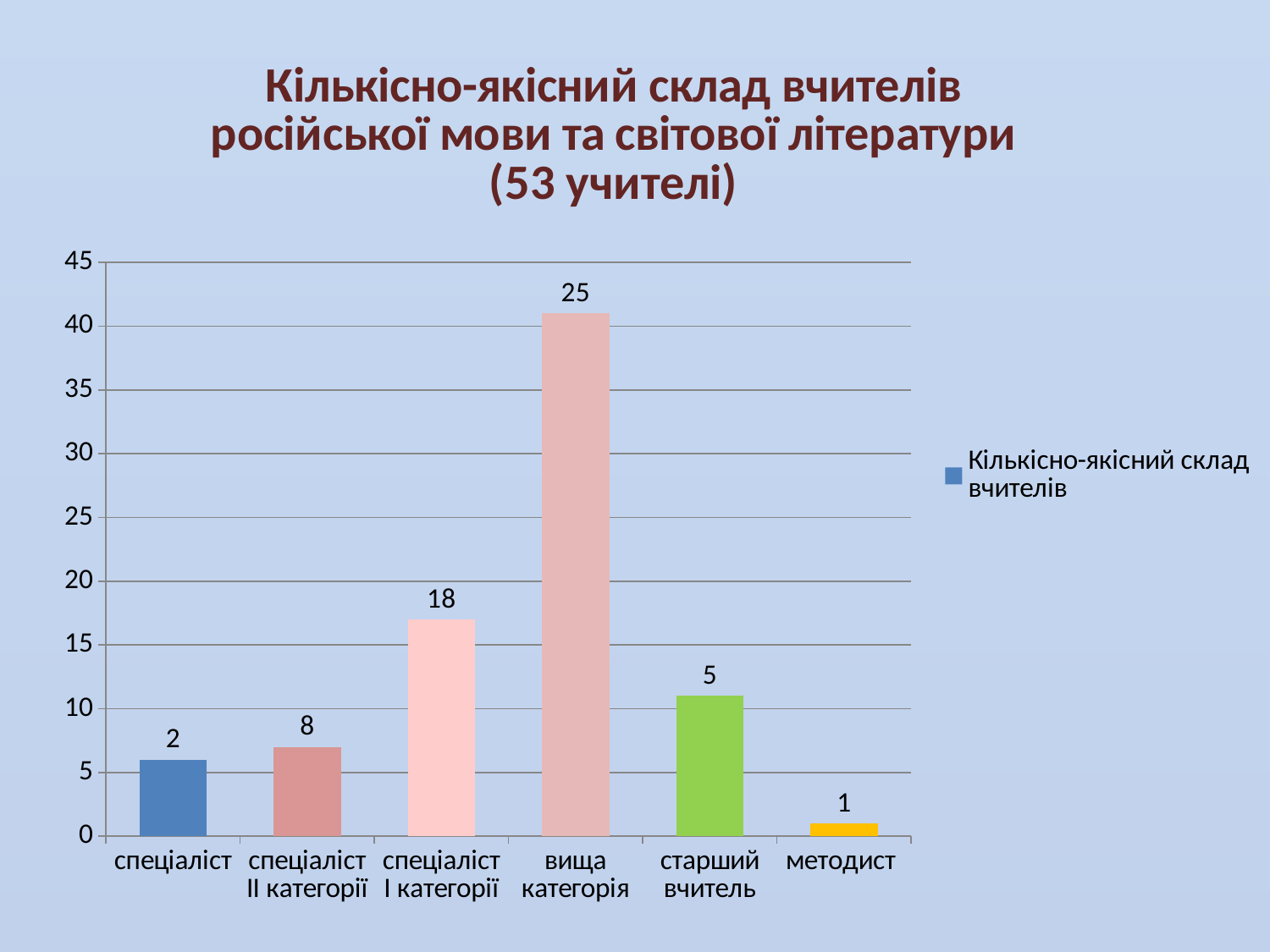
What is the value for спеціаліст ІІ категорії? 8 What is the value for методист? 1 Which category has the lowest value? методист How many categories are shown on the x axis? 6 Which is larger, the value for старший вчитель or the value for спеціаліст? старший вчитель Which category has the highest value? вища категорія How many series does the legend list? 1 What is the value for спеціаліст І категорії? 18 What is the difference between the values for вища категорія and спеціаліст І категорії? 7 What is the difference between the values for спеціаліст ІІ категорії and спеціаліст? 6 What is the value for вища категорія? 25 What kind of chart is shown on the slide? bar chart